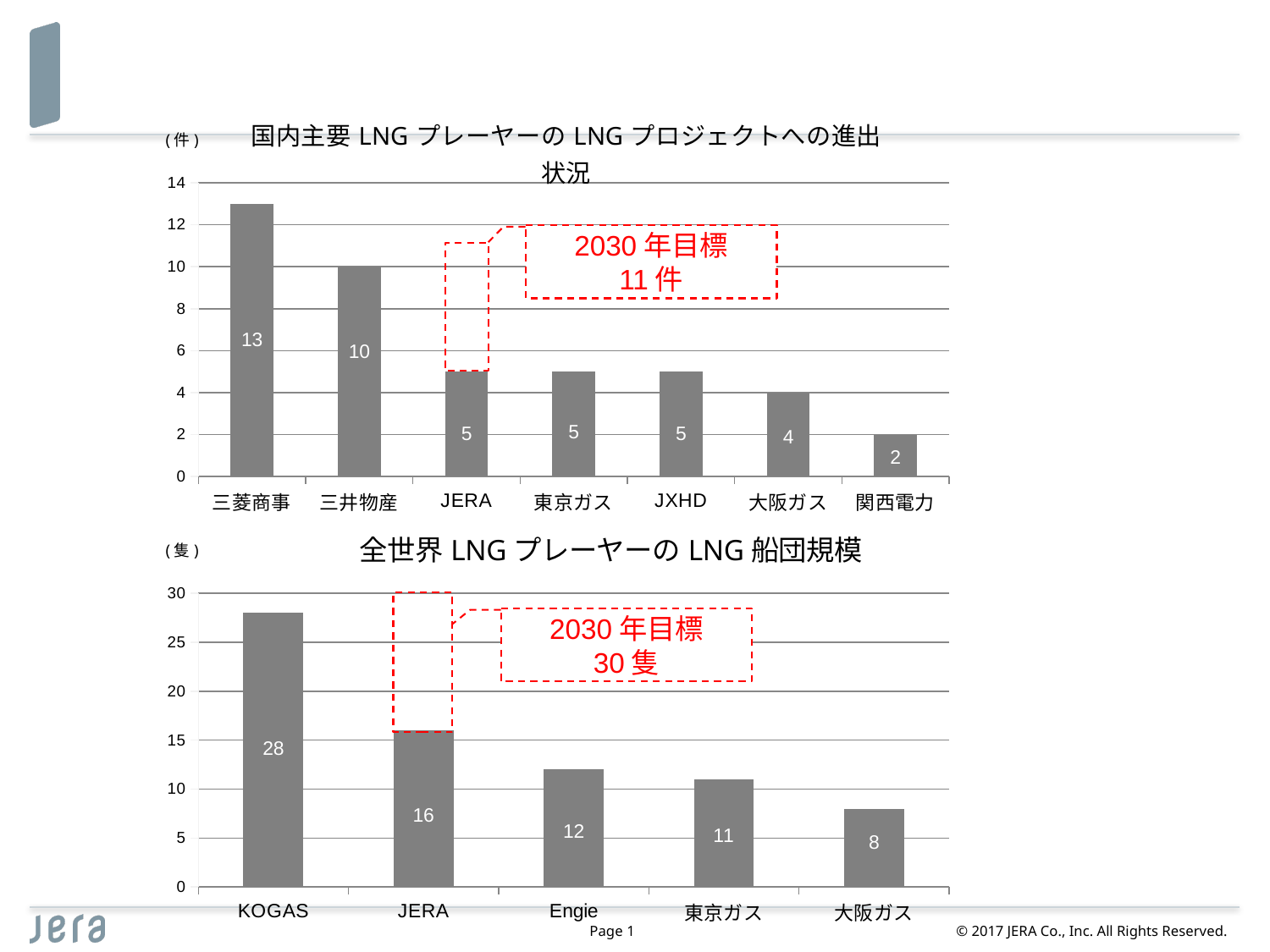
In the top chart (国内主要LNGプレーヤーのLNGプロジェクトへの進出状況), what is the 2030 target shown in the red box? 11件 In the top chart (国内主要LNGプレーヤーのLNGプロジェクトへの進出状況), what is the value for JERA? 5 In the bottom chart (全世界LNGプレーヤーのLNG船団規模), which is larger, Engie or 東京ガス? Engie In the bottom chart (全世界LNGプレーヤーのLNG船団規模), which category has the highest value? KOGAS In the top chart (国内主要LNGプレーヤーのLNGプロジェクトへの進出状況), what is the difference between 三菱商事 and 三井物産? 3 In the bottom chart (全世界LNGプレーヤーのLNG船団規模), what is the difference between KOGAS and JERA? 12 In the bottom chart (全世界LNGプレーヤーのLNG船団規模), what kind of chart is it? bar chart In the top chart (国内主要LNGプレーヤーのLNGプロジェクトへの進出状況), which category has the lowest value? 関西電力 In the bottom chart (全世界LNGプレーヤーのLNG船団規模), what is the value for KOGAS? 28 In the top chart (国内主要LNGプレーヤーのLNGプロジェクトへの進出状況), how many categories are shown? 7 In the bottom chart (全世界LNGプレーヤーのLNG船団規模), do the values rise or fall from left to right? fall In the top chart (国内主要LNGプレーヤーのLNGプロジェクトへの進出状況), what is the value for 三菱商事? 13